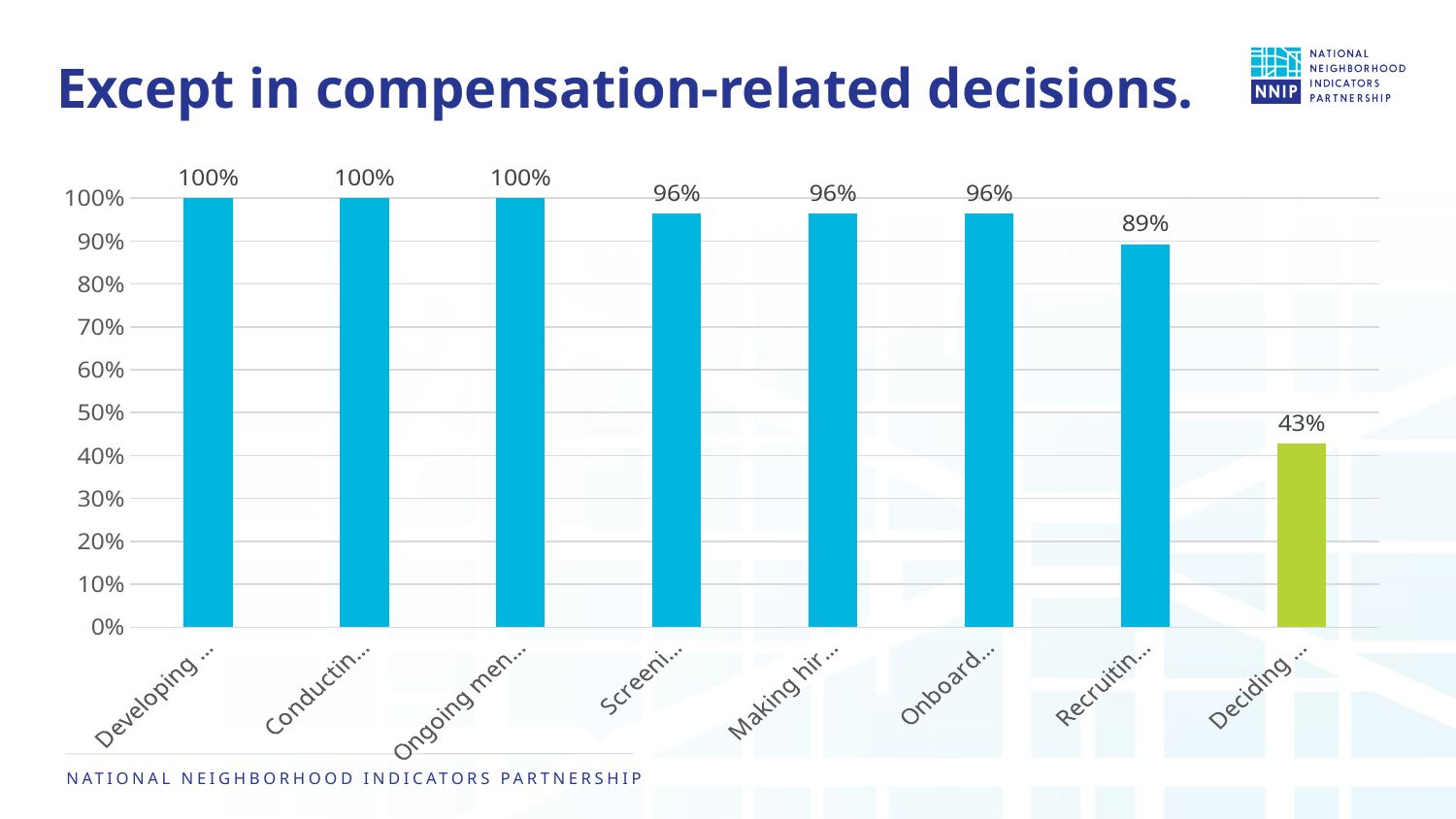
Do the bar values rise or fall from left to right across the chart? fall What is the value of the first bar on the left (labelled "Developing ...")? 100% Which is larger, the value for "Onboard..." or the value for "Recruitin..."? Onboard... How many bars have a value of 100%? 3 What colour is the last bar ("Deciding ..."), which differs from the other bars? Green Is the value of the last bar ("Deciding ...") greater or less than 50%? less What kind of chart is shown on the slide? Bar chart What is the difference between the first bar (100%) and the last bar (43%)? 57 percentage points What is the value of the last bar on the right (labelled "Deciding ...")? 43% What is the value of the bar labelled "Recruitin..."? 89% Which bar has the lowest value? The last bar, "Deciding ..." How many bars are plotted in the chart? 8